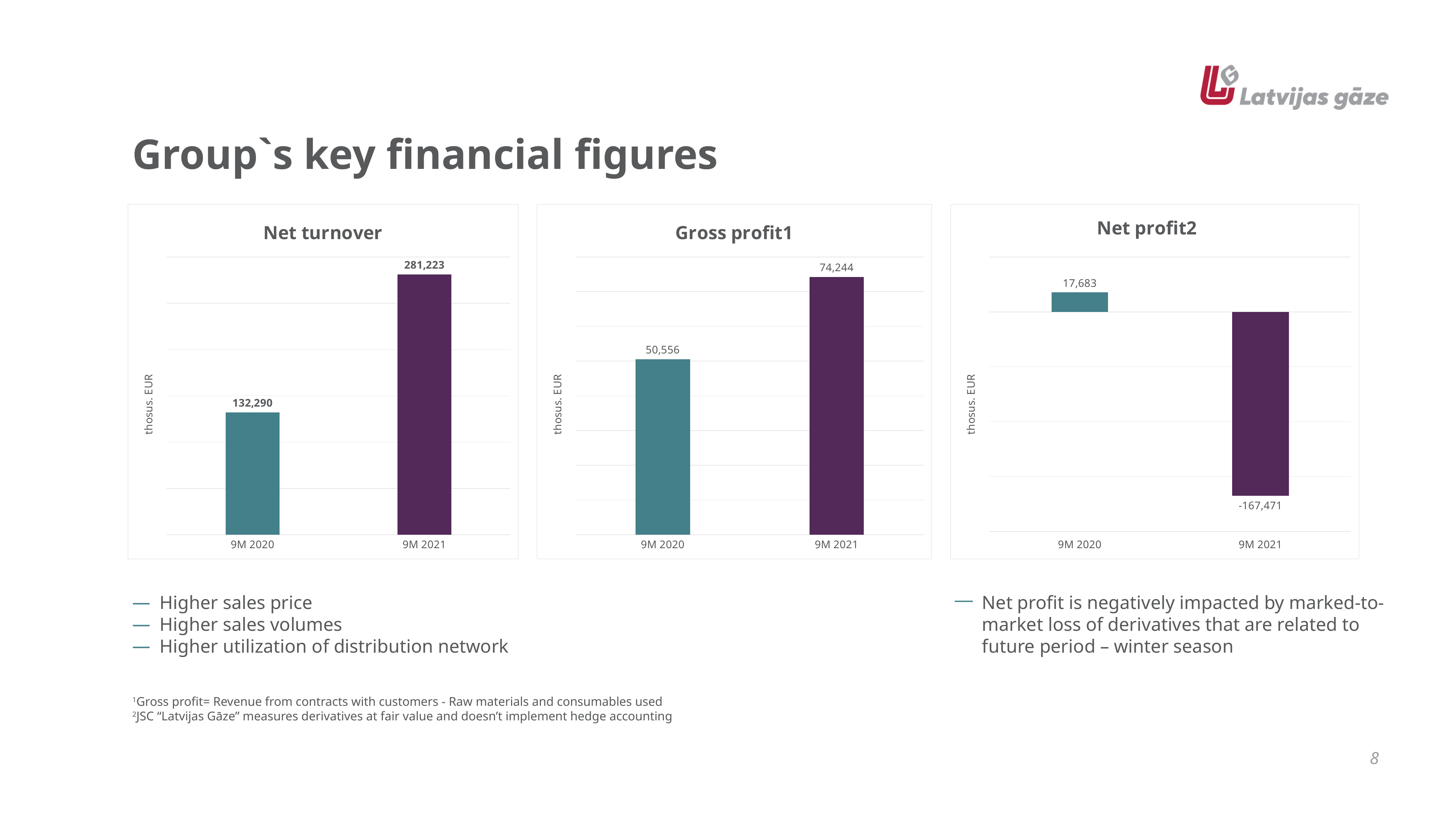
What kind of chart is the Gross profit1 chart? bar chart In the Gross profit1 chart, what is the value for 9M 2020? 50,556 In the Net profit2 chart, which period has the higher value? 9M 2020 In the Net turnover chart, what is the difference between the 9M 2021 and 9M 2020 values? 148,933 In the Gross profit1 chart, what is the difference between the 9M 2021 and 9M 2020 values? 23,688 In the Net profit2 chart, what is the value for 9M 2021? -167,471 In the Gross profit1 chart, which period has the lowest value? 9M 2020 How many categories are shown on the x axis of the Net profit2 chart? 2 What unit is shown on the y axis of the Net turnover chart? thosus. EUR In the Net turnover chart, is the value for 9M 2021 larger or smaller than the value for 9M 2020? larger In the Net turnover chart, what is the value for 9M 2020? 132,290 In the Net turnover chart, what is the value for 9M 2021? 281,223